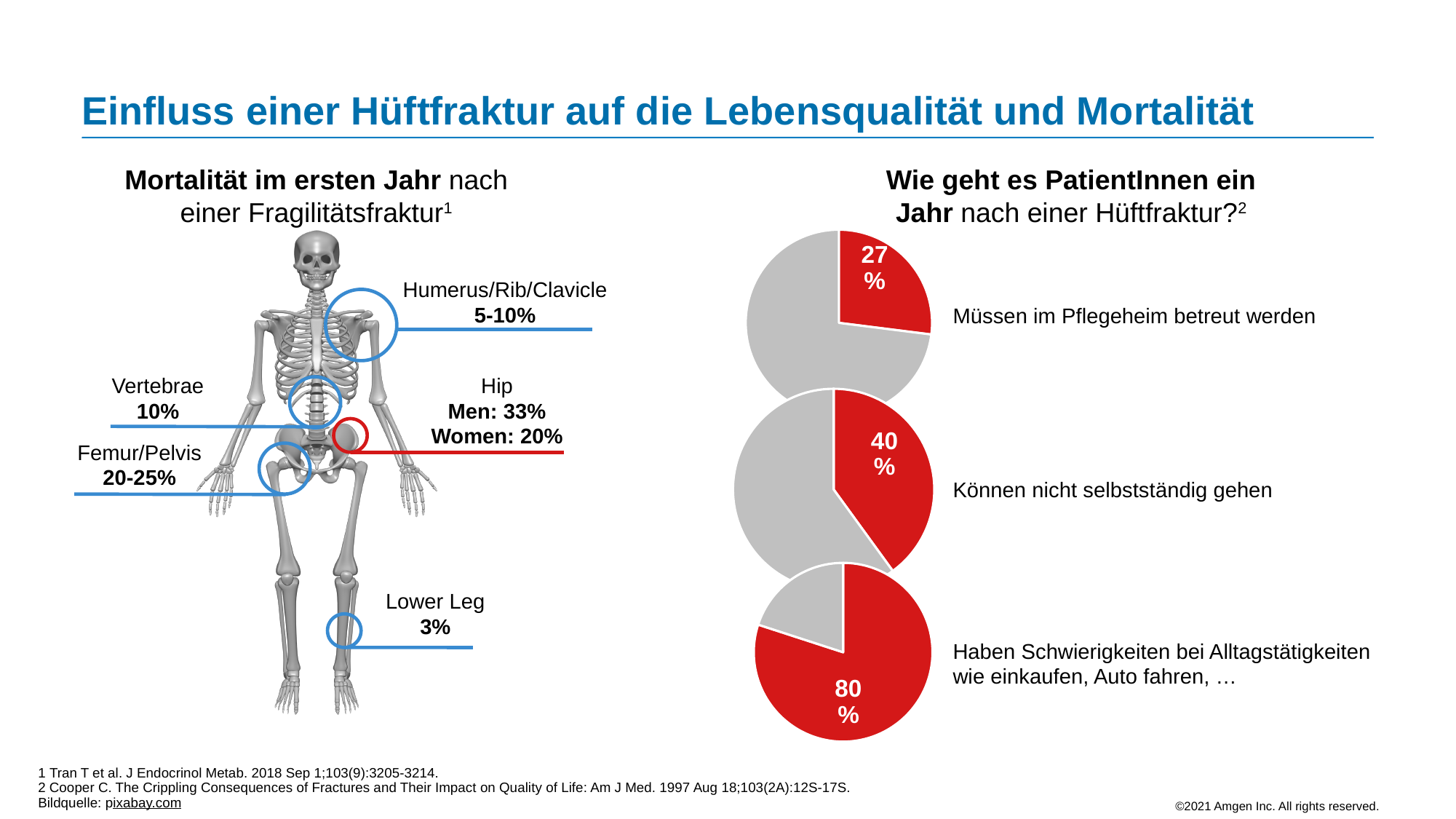
What kind of charts are shown on the right side of the slide? Pie charts In the pie charts on the right, what is the difference in percentage points between the share with difficulties in everyday activities and the share needing nursing home care? 53 percentage points In the bottom pie chart on the right, what percentage of patients have difficulties with everyday activities (Haben Schwierigkeiten bei Alltagstätigkeiten)? 80% Among the three pie charts on the right, which outcome has the largest red share? Haben Schwierigkeiten bei Alltagstätigkeiten In the bottom pie chart on the right, what share of the pie is shown in red? 80% What colour is used for the highlighted slice in each of the pie charts on the right? Red In the top pie chart on the right, what percentage of patients must be cared for in a nursing home (Müssen im Pflegeheim betreut werden)? 27% What is the title above the pie charts on the right side of the slide? Wie geht es PatientInnen ein Jahr nach einer Hüftfraktur? How many pie charts are shown on the right side of the slide? 3 In the pie charts on the right, which is larger: the share that cannot walk independently or the share that must be cared for in a nursing home? Können nicht selbstständig gehen In the middle pie chart on the right, what percentage of patients cannot walk independently (Können nicht selbstständig gehen)? 40% Among the three pie charts on the right, which outcome has the smallest red share? Müssen im Pflegeheim betreut werden